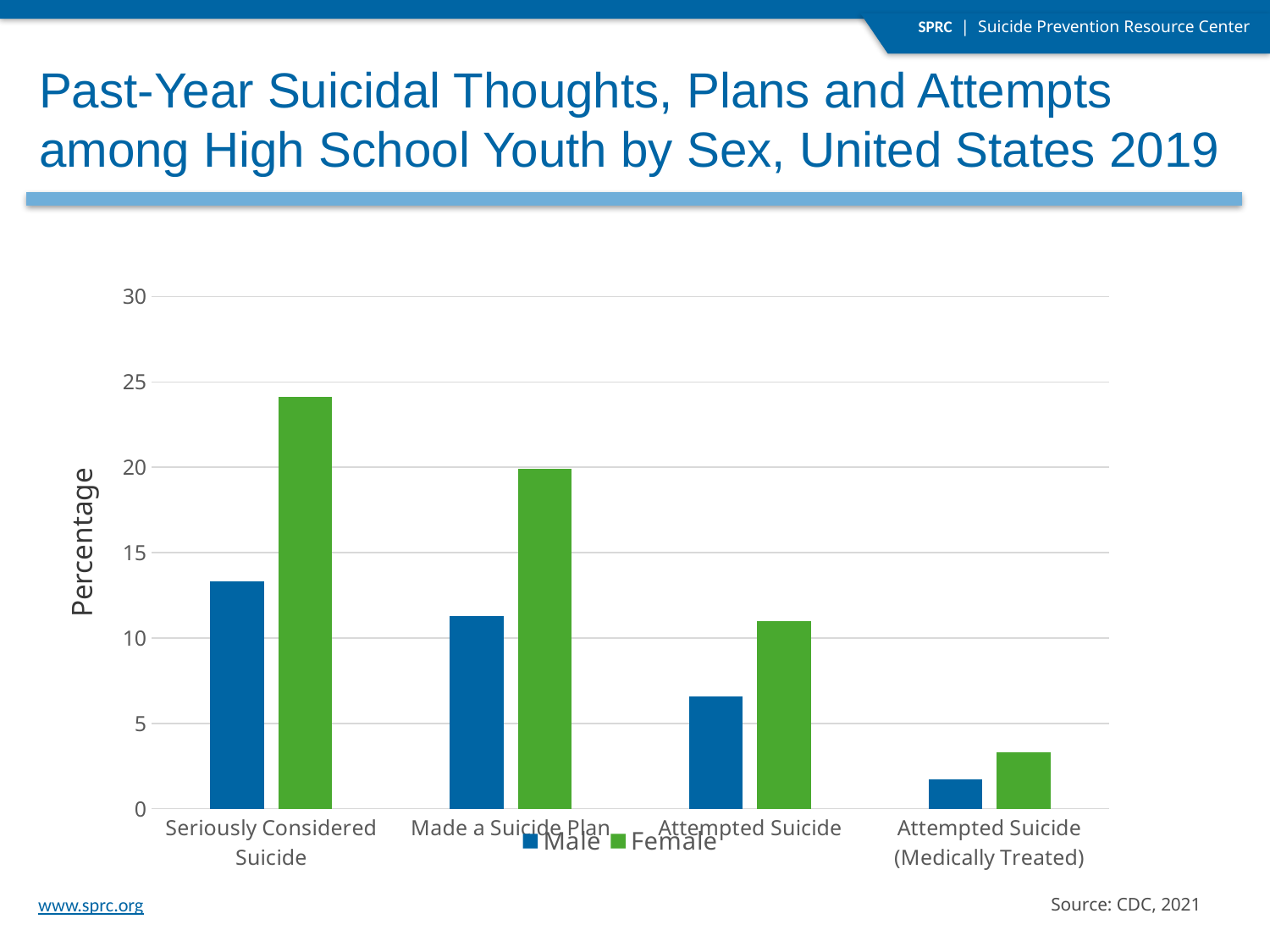
Is the Female value for Seriously Considered Suicide greater or less than 20? greater Which is larger for Attempted Suicide, the Male value or the Female value? Female Do the Male values rise or fall moving from left to right across the categories? Fall What is the label on the y axis? Percentage What kind of chart is shown on the slide? Bar chart How many series does the legend list? 2 How many categories are shown on the x axis? 4 Which category has the lowest Male value? Attempted Suicide (Medically Treated) Is the Male value for Made a Suicide Plan greater or less than 15? less Is the Male value for Attempted Suicide greater or less than 5? greater Which category has the highest Female value? Seriously Considered Suicide